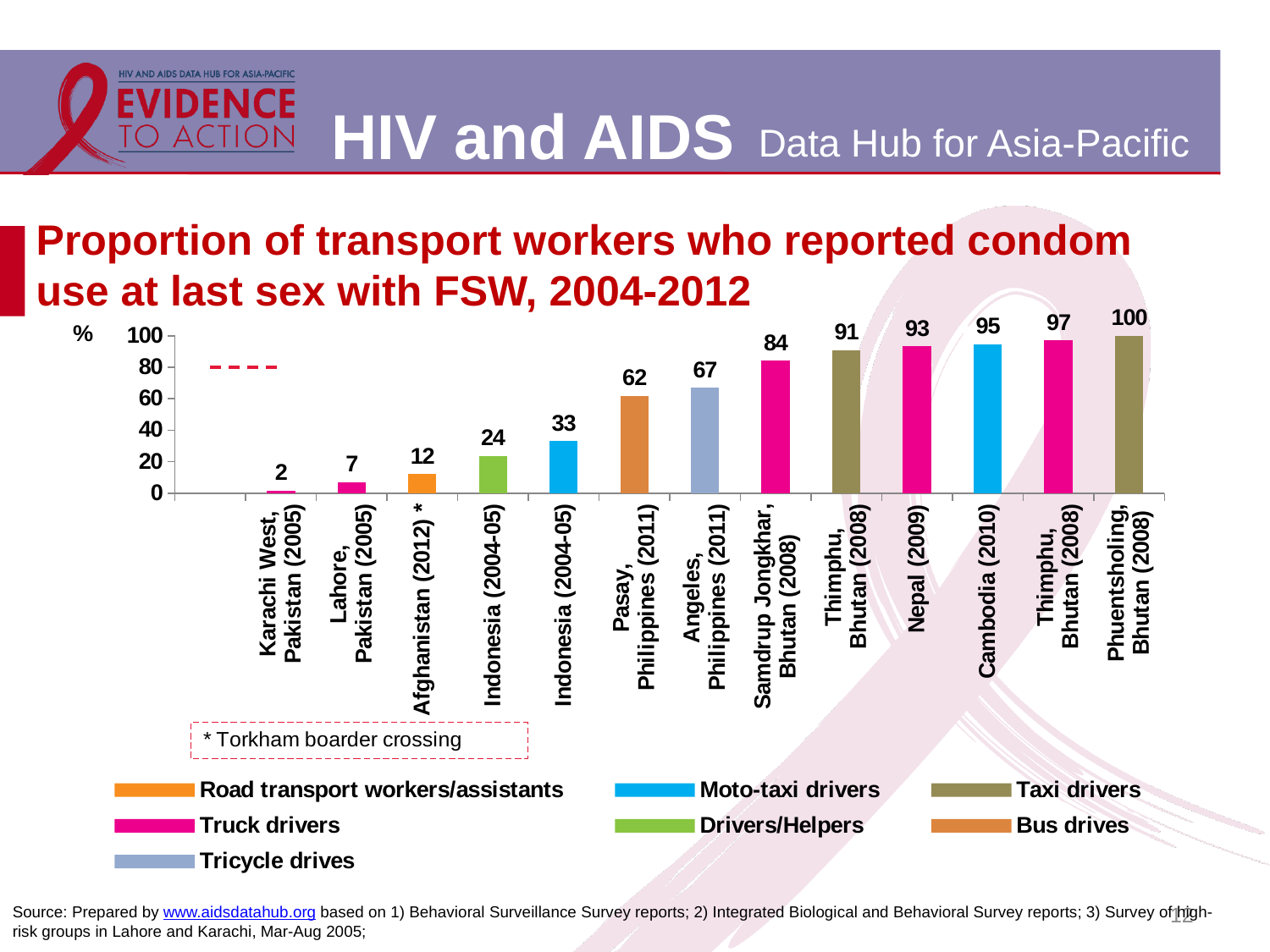
Which category has the lowest value? Karachi West, Pakistan (2005) What is the value for Pasay, Philippines (2011)? 62 How many series does the legend list? 7 Which category has the highest value? Phuentsholing, Bhutan (2008) Is the value for Lahore, Pakistan (2005) greater or less than 20? less What is the value for Karachi West, Pakistan (2005)? 2 What is the difference between the values for Angeles, Philippines (2011) and Pasay, Philippines (2011)? 5 Which is larger, the value for Nepal (2009) or the value for Afghanistan (2012)? Nepal (2009) What is the value for Cambodia (2010)? 95 How many categories are plotted on the chart? 13 What kind of chart is shown on the slide? bar chart What is the value for Samdrup Jongkhar, Bhutan (2008)? 84